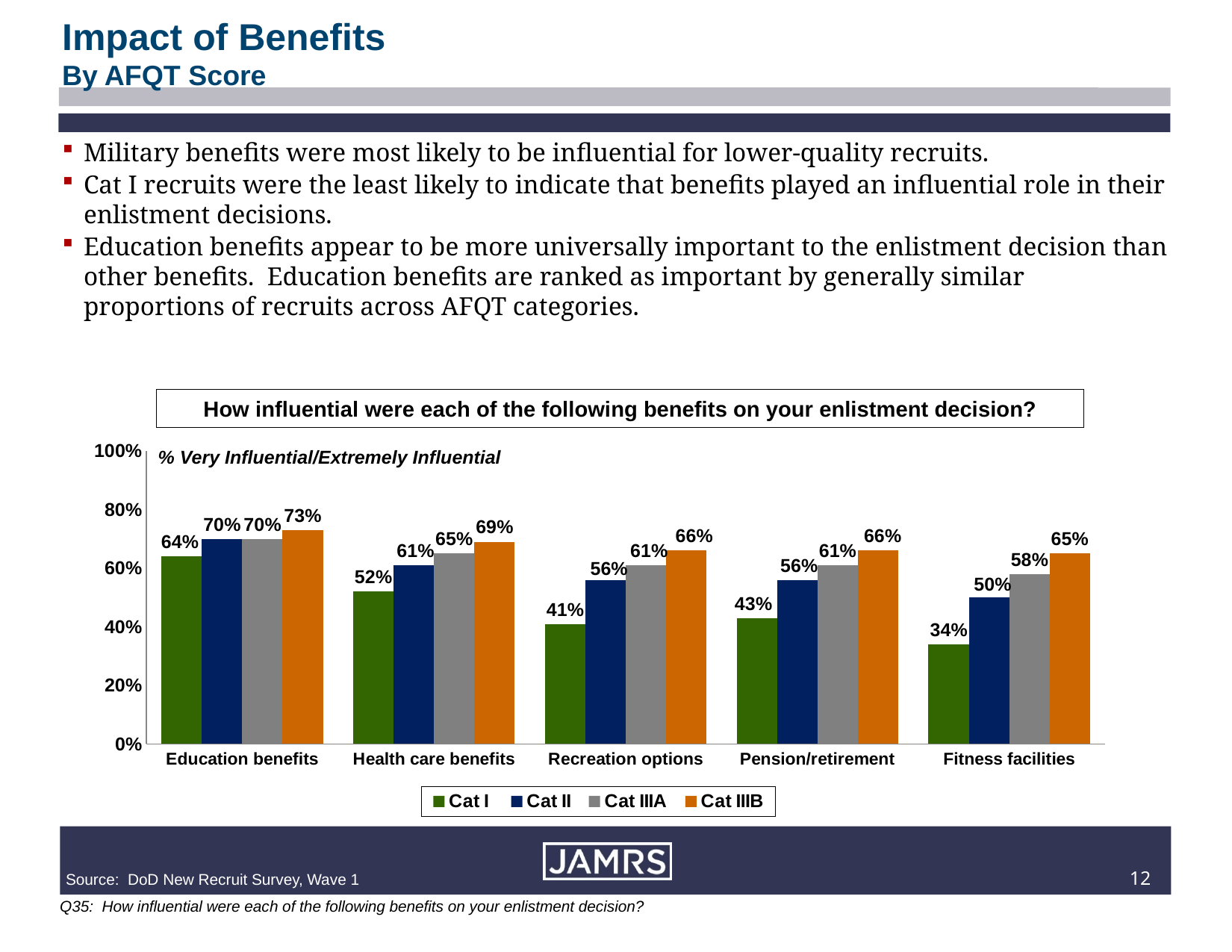
Which category has the lowest Cat I value? Fitness facilities What is the value for Cat I for Education benefits? 64% Which is larger for Health care benefits: the Cat I value or the Cat IIIA value? Cat IIIA How many series does the legend list? 4 What kind of chart is shown on the slide? Bar chart What is the value for Cat IIIB for Fitness facilities? 65% What is the value for Cat II for Recreation options? 56% What is the title of the chart? How influential were each of the following benefits on your enlistment decision? What is the difference between the Cat IIIB and Cat I values for Fitness facilities? 31% Do the Cat I values rise or fall from Education benefits to Fitness facilities? Fall Which category has the highest Cat IIIB value? Education benefits How many benefit categories are shown on the x axis? 5